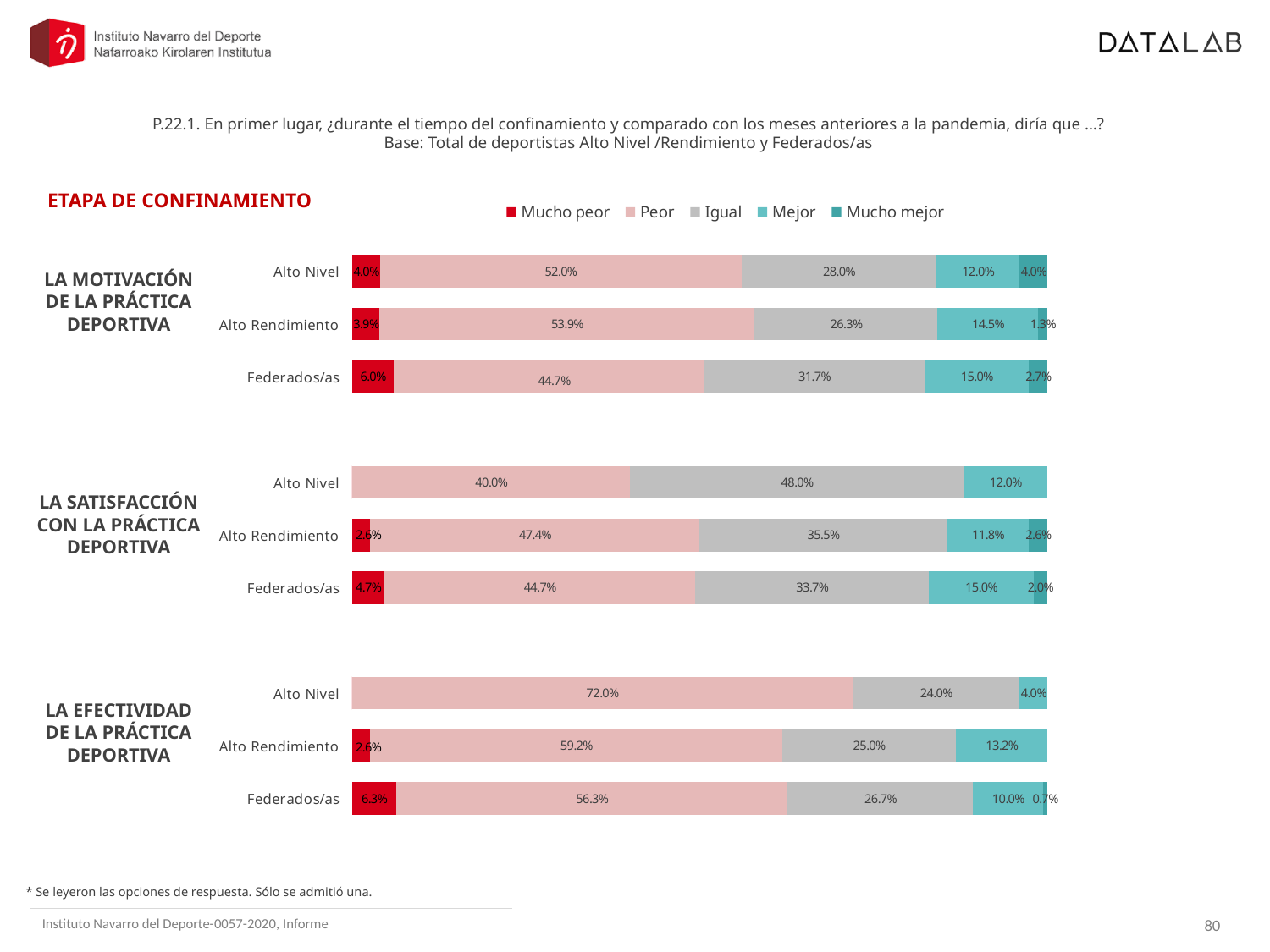
In the chart for LA MOTIVACIÓN DE LA PRÁCTICA DEPORTIVA, which is larger: the "Mejor" value for Alto Rendimiento or for Alto Nivel? Alto Rendimiento How many categories are shown in the chart for LA EFECTIVIDAD DE LA PRÁCTICA DEPORTIVA? 3 In the chart for LA MOTIVACIÓN DE LA PRÁCTICA DEPORTIVA, what is the value of "Igual" for Federados/as? 31.7% In the chart for LA EFECTIVIDAD DE LA PRÁCTICA DEPORTIVA, what is the value of "Mucho peor" for Federados/as? 6.3% In the chart for LA MOTIVACIÓN DE LA PRÁCTICA DEPORTIVA, what is the value of "Peor" for Alto Nivel? 52.0% In the chart for LA MOTIVACIÓN DE LA PRÁCTICA DEPORTIVA, which category has the highest "Mucho peor" value? Federados/as In the chart for LA EFECTIVIDAD DE LA PRÁCTICA DEPORTIVA, what is the value of "Peor" for Alto Nivel? 72.0% In the chart for LA SATISFACCIÓN CON LA PRÁCTICA DEPORTIVA, what is the difference between the "Peor" values for Alto Rendimiento and Alto Nivel? 7.4% In the chart for LA EFECTIVIDAD DE LA PRÁCTICA DEPORTIVA, which category has the lowest "Peor" value? Federados/as What kind of chart is used for LA SATISFACCIÓN CON LA PRÁCTICA DEPORTIVA? Stacked bar chart How many series does the legend list? 5 In the chart for LA SATISFACCIÓN CON LA PRÁCTICA DEPORTIVA, what is the value of "Igual" for Alto Nivel? 48.0%